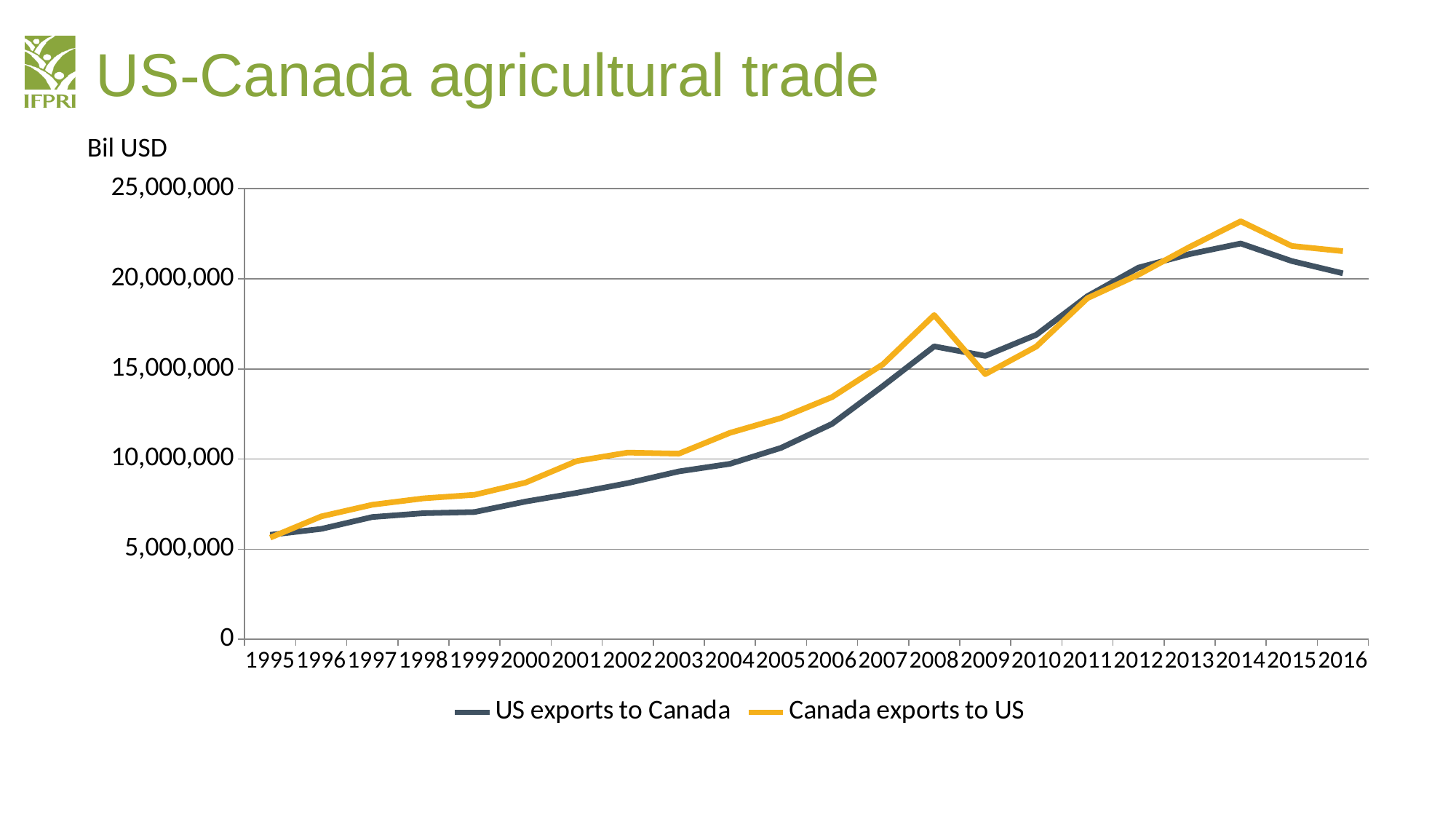
In 2009, which series has the larger value: US exports to Canada or Canada exports to US? US exports to Canada Is the value for Canada exports to US in 2008 greater or less than 15,000,000? greater In which year is US exports to Canada at its lowest value? 1995 Is the value for US exports to Canada in 1995 greater or less than 10,000,000? less How many series does the legend list? 2 What kind of chart is shown on the slide? line chart Is the value for Canada exports to US in 2014 greater or less than 20,000,000? greater In which year does Canada exports to US reach its highest value? 2014 In 2008, which series has the larger value: US exports to Canada or Canada exports to US? Canada exports to US Overall, do the values for US exports to Canada rise or fall from 1995 to 2016? rise How many years are plotted along the x axis? 22